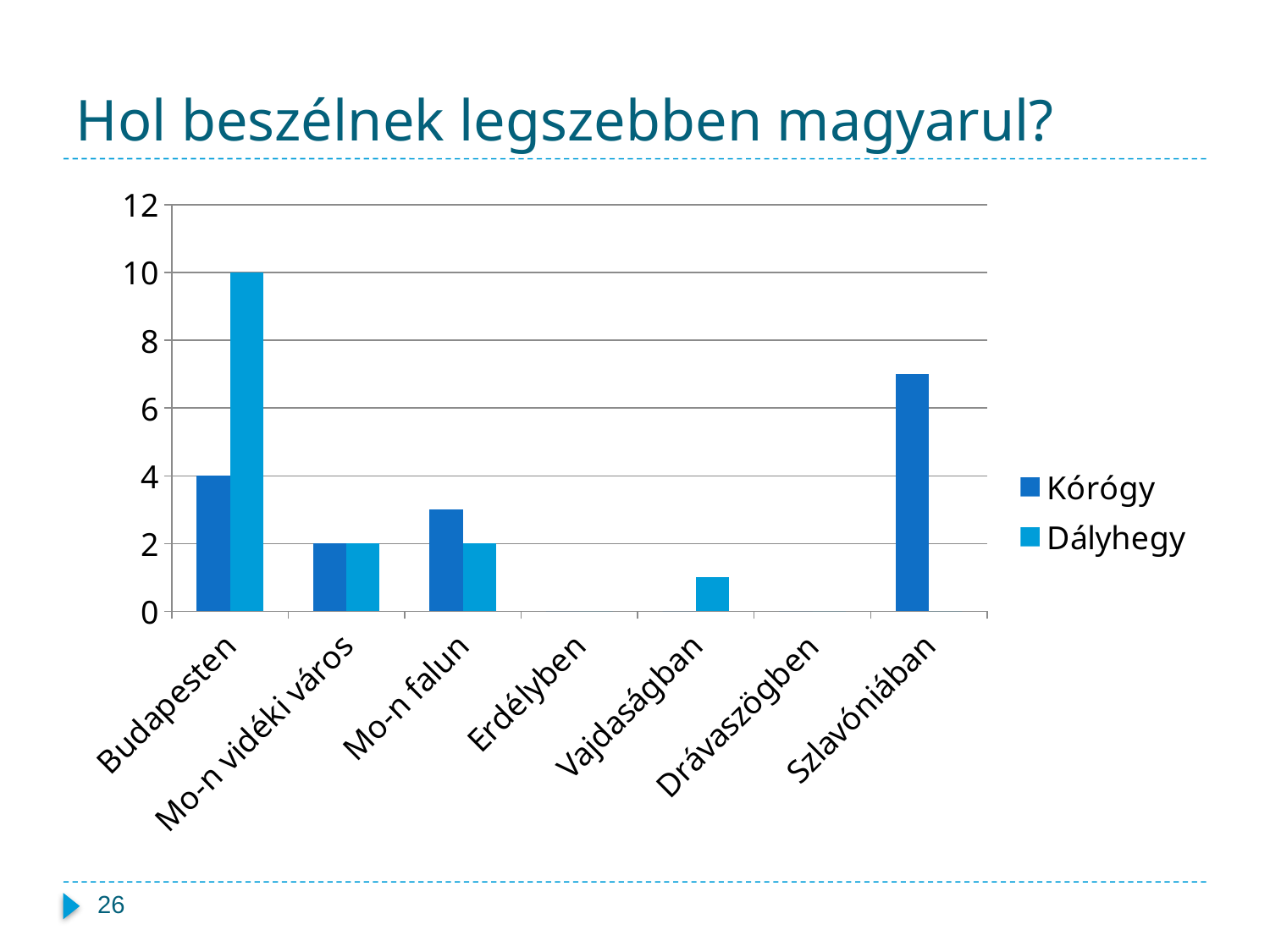
What is the value for Dályhegy at Budapesten? 10 What is the value for Dályhegy at Mo-n falun? 2 What is the title of the chart? Hol beszélnek legszebben magyarul? Which category has the highest value for the Kórógy series? Szlavóniában What kind of chart is shown on the slide? bar chart How many series does the legend list? 2 How many categories are shown on the x axis? 7 Is the value for Kórógy at Szlavóniában greater or less than 6? greater What is the value for Kórógy at Budapesten? 4 What is the difference between the Dályhegy and Kórógy values at Budapesten? 6 What is the value for Kórógy at Mo-n vidéki város? 2 Which category has the highest value for the Dályhegy series? Budapesten